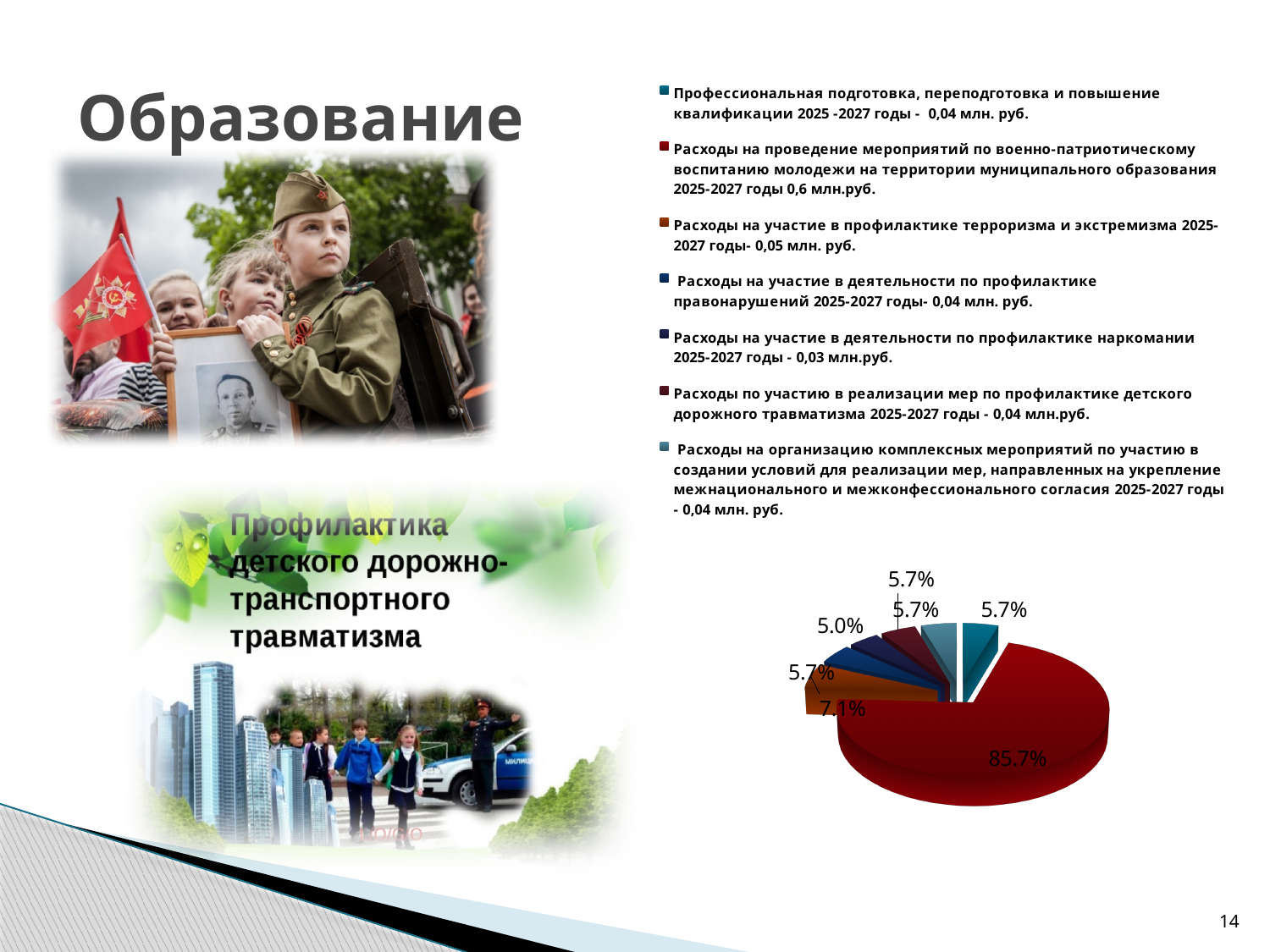
What is the value of the smallest slice in the pie chart? 5.0% What is the value of the largest slice in the pie chart? 85.7% What is the difference between the 7.1% slice and the 5.0% slice? 2.1% What colour is the largest slice of the pie chart? red What is the second-largest value shown in the pie chart? 7.1% How many slices in the pie chart are labelled 5.7%? 4 Is the largest slice of the pie chart greater or less than 50%? greater What is the combined share of the 7.1% and 5.0% slices? 12.1% How many slices does the pie chart have? 7 What kind of chart is shown on the slide? pie chart What is the difference between the largest slice (85.7%) and the 7.1% slice? 78.6% Which is larger in the pie chart: the 7.1% slice or the 5.0% slice? 7.1%